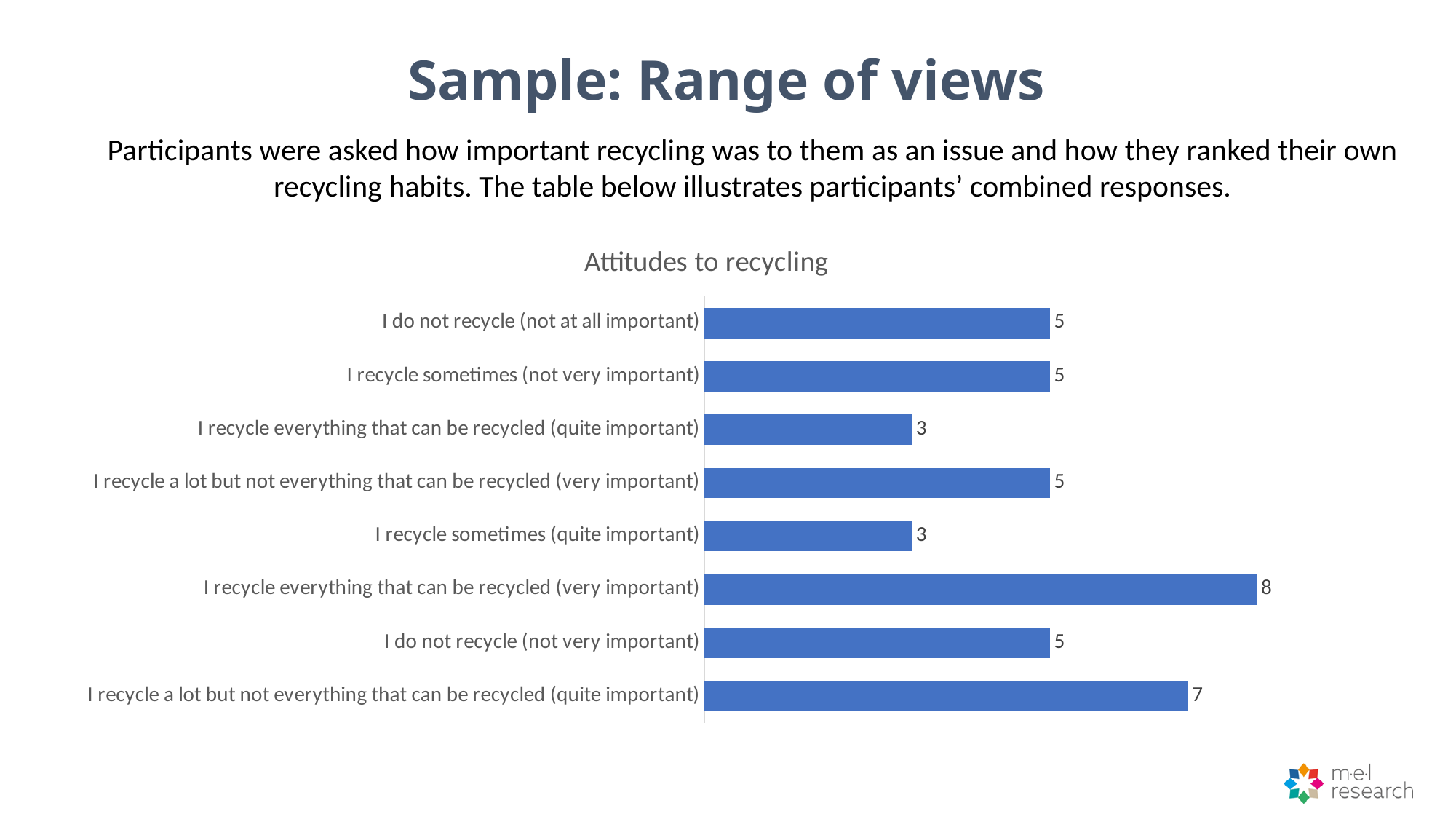
What is the value for 'I recycle everything that can be recycled (very important)'? 8 What is the title of the chart? Attitudes to recycling What is the value for 'I do not recycle (not very important)'? 5 What is the difference between 'I recycle everything that can be recycled (very important)' and 'I recycle a lot but not everything that can be recycled (quite important)'? 1 How many categories are shown in the chart? 8 Which category has the highest value? I recycle everything that can be recycled (very important) What is the value for 'I recycle a lot but not everything that can be recycled (quite important)'? 7 What kind of chart is shown on the slide? Bar chart What is the difference between 'I do not recycle (not at all important)' and 'I recycle everything that can be recycled (quite important)'? 2 Which is larger: 'I recycle sometimes (not very important)' or 'I recycle sometimes (quite important)'? I recycle sometimes (not very important) How many categories have a value of 3? 2 What is the value for 'I recycle sometimes (quite important)'? 3